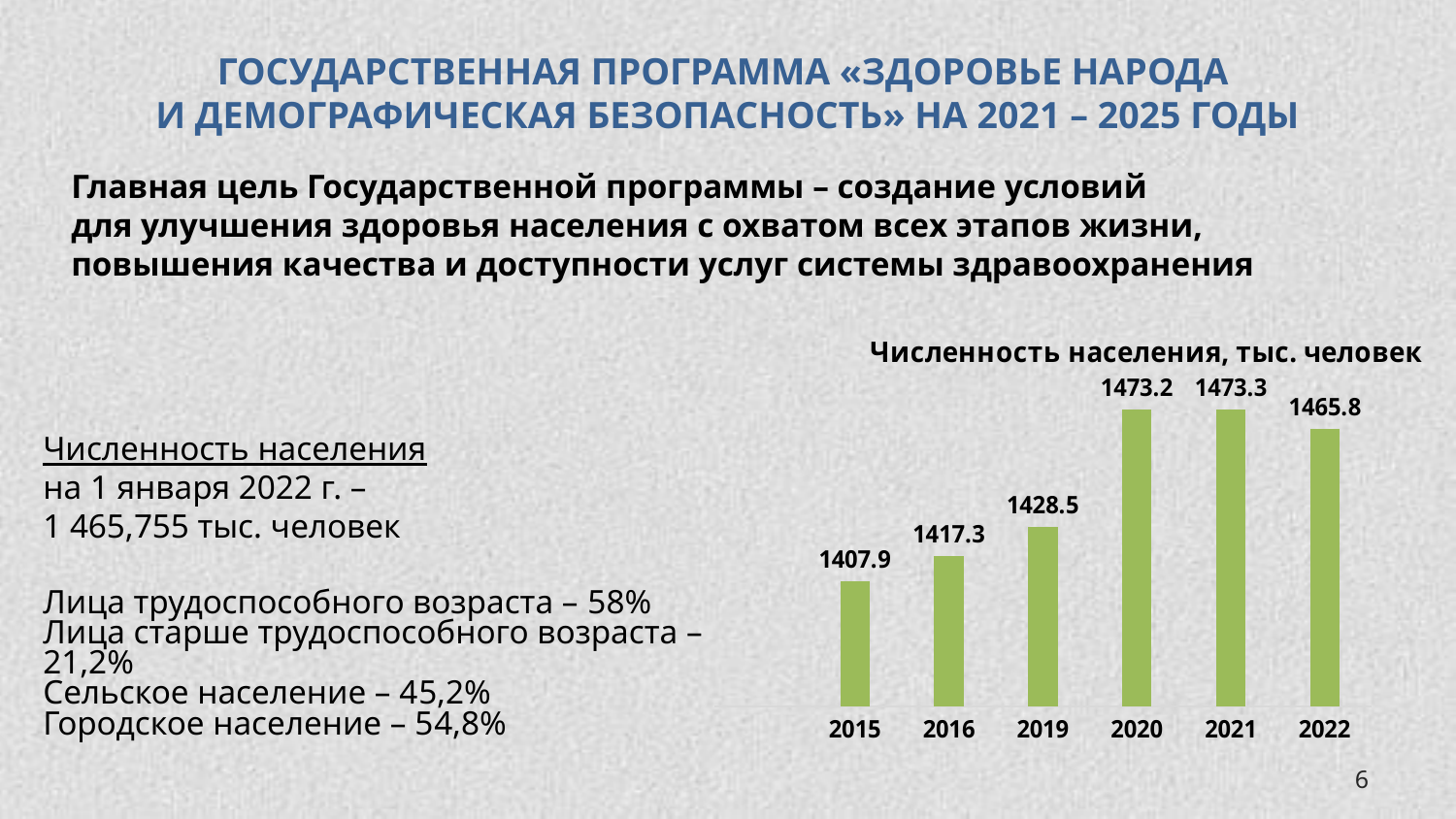
Does the population value rise or fall from 2021 to 2022? Fall How many years (bars) are shown in the chart? 6 Which year has the lowest population value in the chart? 2015 What is the population value shown for 2015? 1407.9 What type of chart is shown on the slide? Bar chart Which is larger, the population value for 2016 or for 2019? 2019 What is the population value shown for 2019? 1428.5 What is the difference between the population values for 2022 and 2015? 57.9 Which year has the highest population value in the chart? 2021 What is the population value shown for 2022? 1465.8 What is the difference between the population values for 2020 and 2019? 44.7 What is the title of the chart? Численность населения, тыс. человек